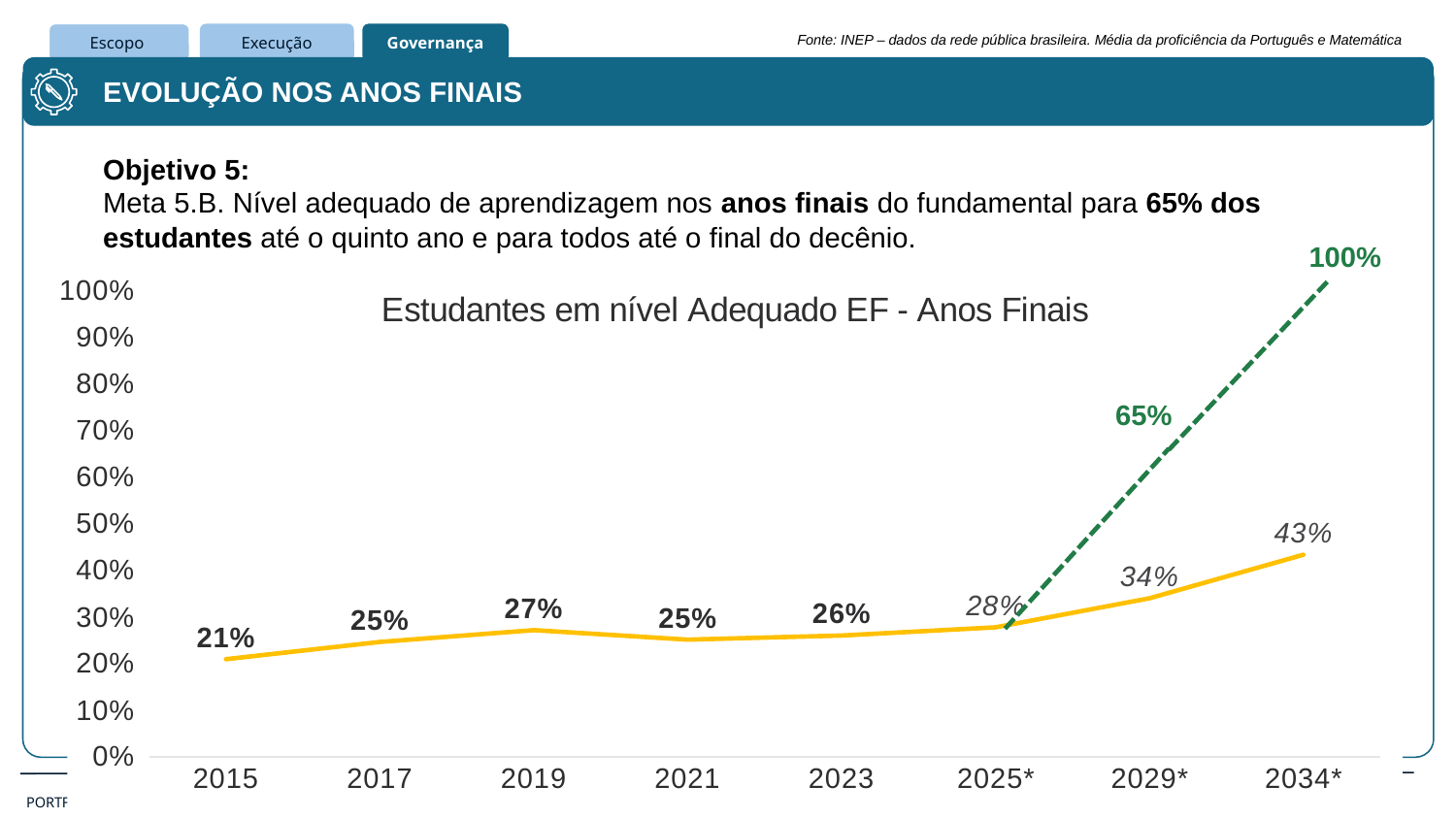
What is the value for 2034* on the green dashed line? 100% What is the value for 2029* on the green dashed line? 65% What is the difference between the green dashed line and the yellow line at 2034*? 57% What is the value for 2034* on the yellow line? 43% Which year has the lowest value on the yellow line? 2015 Which year has the highest value on the yellow line? 2034* How many years are shown on the x axis? 8 What is the value for 2019 on the yellow line? 27% What is the title of the chart? Estudantes em nível Adequado EF - Anos Finais What is the value for 2015 on the yellow line? 21% Which is larger on the yellow line: the value for 2019 or the value for 2021? 2019 What kind of chart is shown on the slide? Line chart